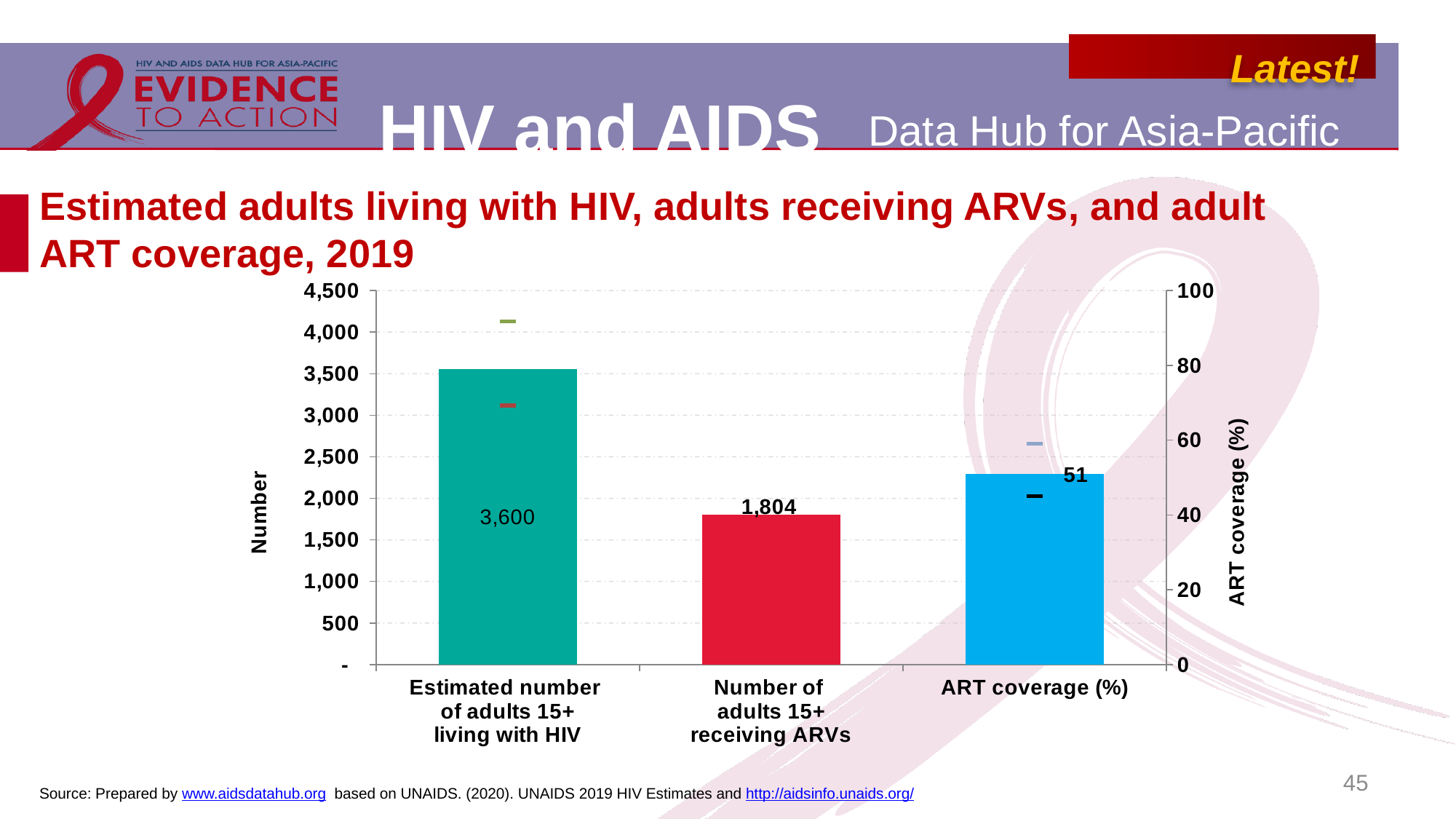
What kind of chart is shown on the slide? Bar chart What is the estimated number of adults 15+ living with HIV shown on the chart? 3,600 Is the ART coverage (%) value greater or less than 60 on the right-hand axis? less What is the ART coverage (%) value shown on the chart? 51 Which year does the chart title say the data refer to? 2019 What is the title of the right vertical axis of the chart? ART coverage (%) Which is larger: the estimated number of adults 15+ living with HIV or the number of adults 15+ receiving ARVs? Estimated number of adults 15+ living with HIV What is the title of the left vertical axis of the chart? Number How many bars are plotted on the chart? 3 Is the number of adults 15+ receiving ARVs greater or less than 2,000? less What is the number of adults 15+ receiving ARVs shown on the chart? 1,804 What is the difference between the estimated number of adults 15+ living with HIV and the number of adults 15+ receiving ARVs? 1,796